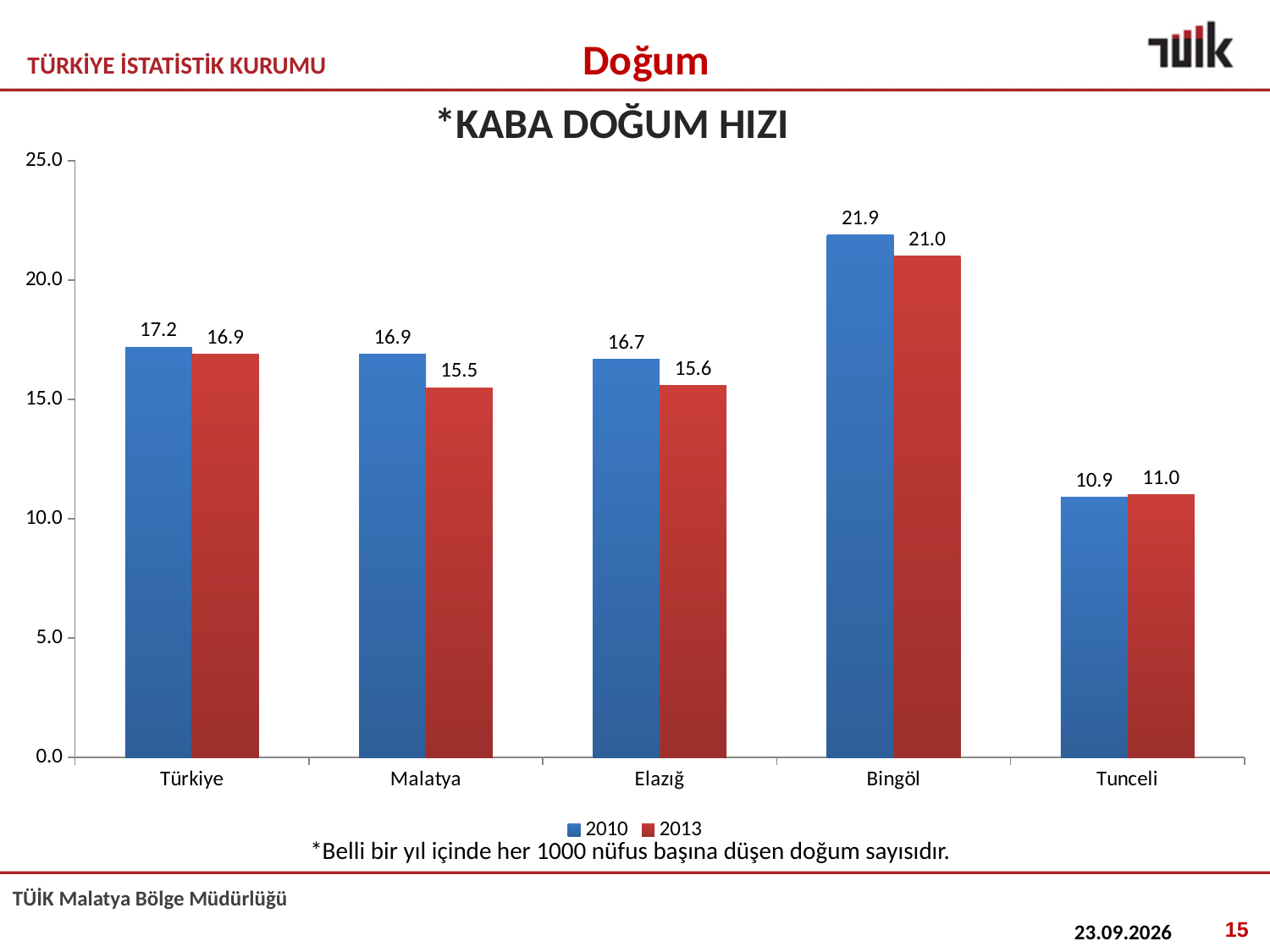
How many series does the legend list? 2 What is the difference between the 2010 values for Bingöl and Tunceli? 11.0 Is the 2013 value for Bingöl greater or less than 20.0? greater Which category has the highest 2010 value? Bingöl What is the 2013 value for Türkiye? 16.9 What is the 2010 value for Bingöl? 21.9 What is the 2013 value for Malatya? 15.5 Which category has the lowest 2013 value? Tunceli What is the difference between the 2010 and 2013 values for Malatya? 1.4 How many categories are shown on the x axis? 5 What kind of chart is shown on the slide? bar chart Which is larger for Elazığ: the 2010 value or the 2013 value? 2010